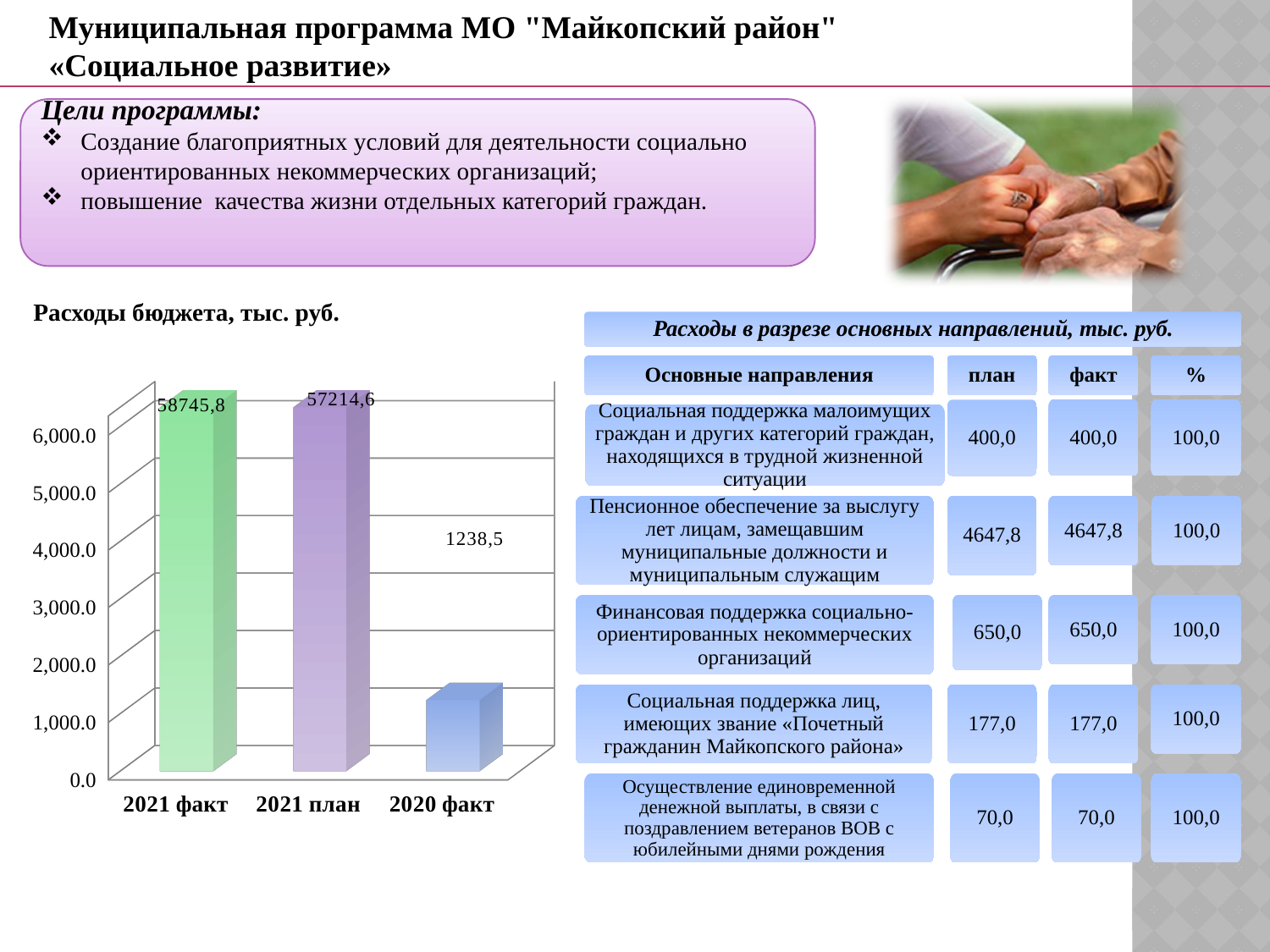
What is the difference between the values for 2021 факт and 2021 план in the chart 'Расходы бюджета, тыс. руб.'? 1531,2 What is the value for 2021 факт in the chart 'Расходы бюджета, тыс. руб.'? 58745,8 In the chart 'Расходы бюджета, тыс. руб.', which is larger: the value for 2021 план or the value for 2020 факт? 2021 план What is the value for 2020 факт in the chart 'Расходы бюджета, тыс. руб.'? 1238,5 Do the values rise or fall from left to right along the x axis in the chart 'Расходы бюджета, тыс. руб.'? fall In the chart 'Расходы бюджета, тыс. руб.', is the bar for 2020 факт greater or less than 2,000.0 on the axis? less What is the value for 2021 план in the chart 'Расходы бюджета, тыс. руб.'? 57214,6 How many categories are shown in the chart 'Расходы бюджета, тыс. руб.'? 3 Which category has the lowest value in the chart 'Расходы бюджета, тыс. руб.'? 2020 факт What is the difference between the values for 2021 план and 2020 факт in the chart 'Расходы бюджета, тыс. руб.'? 55976,1 Which category has the highest value in the chart 'Расходы бюджета, тыс. руб.'? 2021 факт What kind of chart is 'Расходы бюджета, тыс. руб.'? bar chart